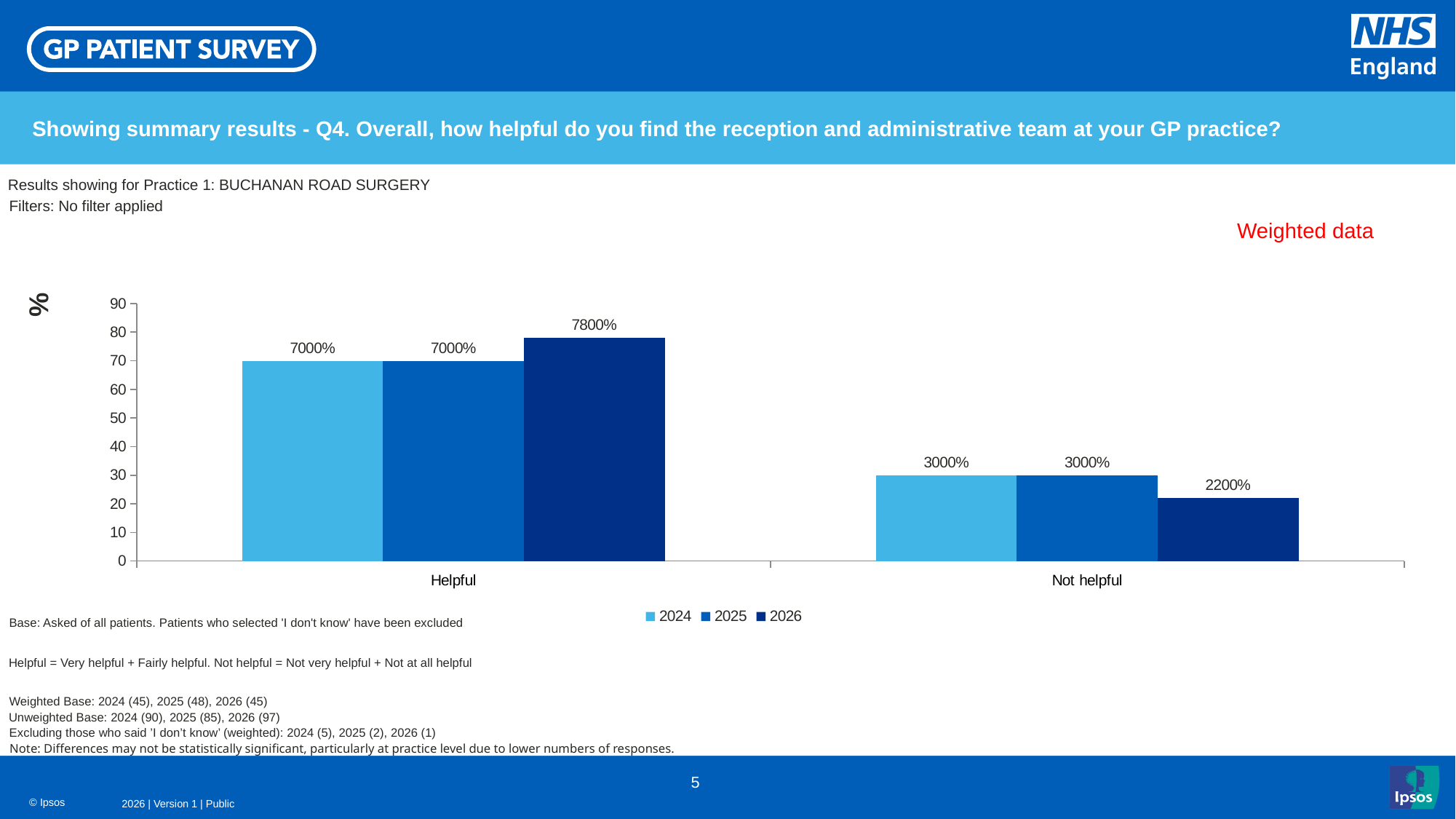
Is the 2026 value for Helpful larger or smaller than the 2025 value for Helpful? larger What is the label on the vertical axis of the chart? % What is the value for 2024 in the Not helpful category? 3000% What is the value for 2026 in the Helpful category? 7800% What kind of chart is shown on the slide? bar chart Which year has the highest value in the Helpful category? 2026 Is the 2026 bar for Not helpful greater or less than 30 on the axis? less What is the value for 2026 in the Not helpful category? 2200% Which year has the lowest value in the Not helpful category? 2026 How many series does the legend list? 3 What is the value for 2025 in the Helpful category? 7000% How many categories are shown on the x axis? 2